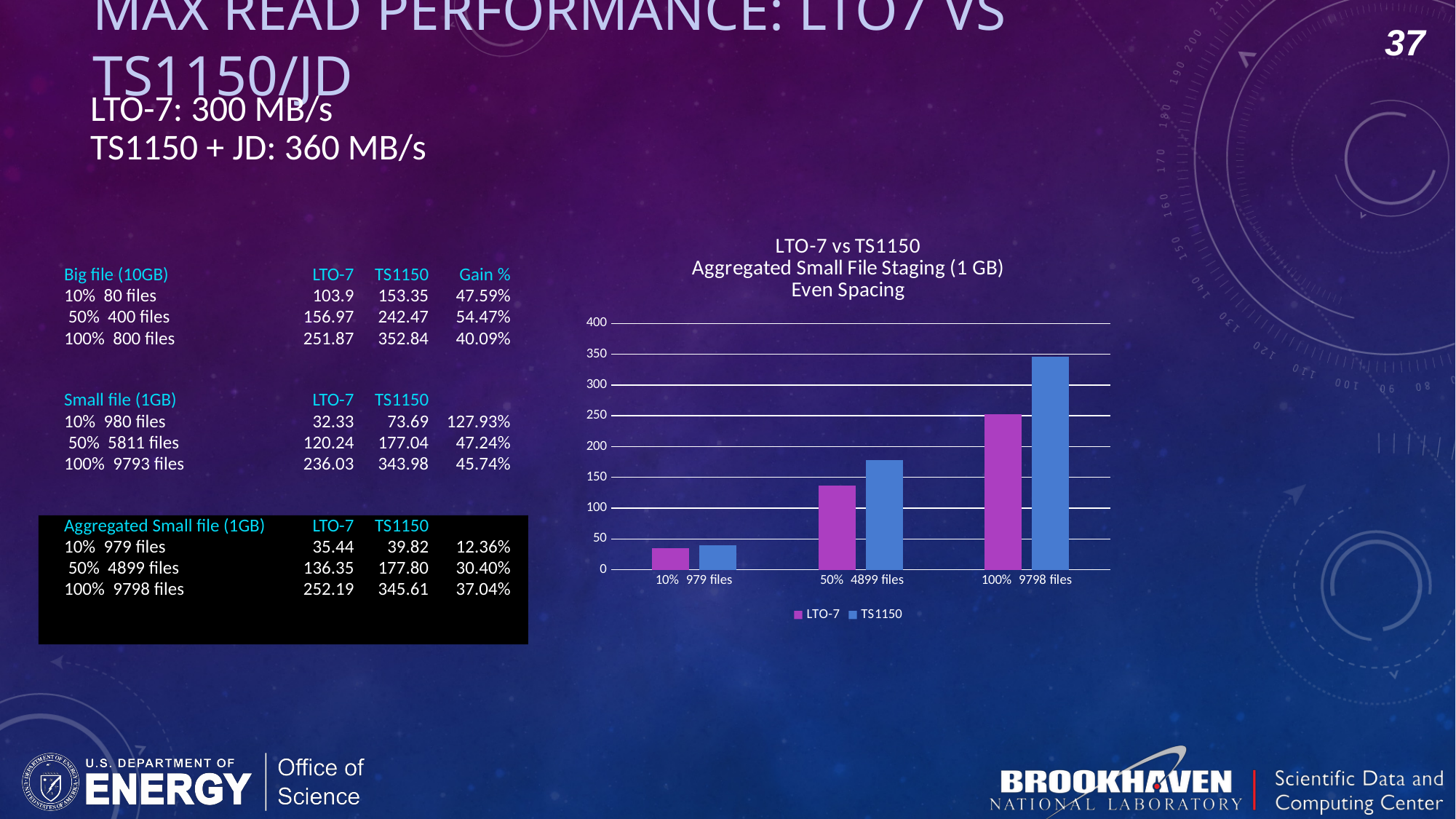
In the chart, is the LTO-7 value for 50% 4899 files greater or less than 150? less Do the TS1150 bars rise or fall from left to right across the x axis? rise For 50% 4899 files, which series has the larger bar in the chart, LTO-7 or TS1150? TS1150 Which category has the highest TS1150 bar in the chart? 100% 9798 files How many series does the chart legend list? 2 What kind of chart is shown on the slide? bar chart How many categories are shown on the x axis of the chart? 3 In the chart, is the TS1150 value for 100% 9798 files greater or less than 300? greater Which colour represents the LTO-7 series in the chart? purple In the chart, is the LTO-7 value for 100% 9798 files greater or less than 300? less Which category has the lowest LTO-7 bar in the chart? 10% 979 files What is the title of the chart? LTO-7 vs TS1150 Aggregated Small File Staging (1 GB) Even Spacing